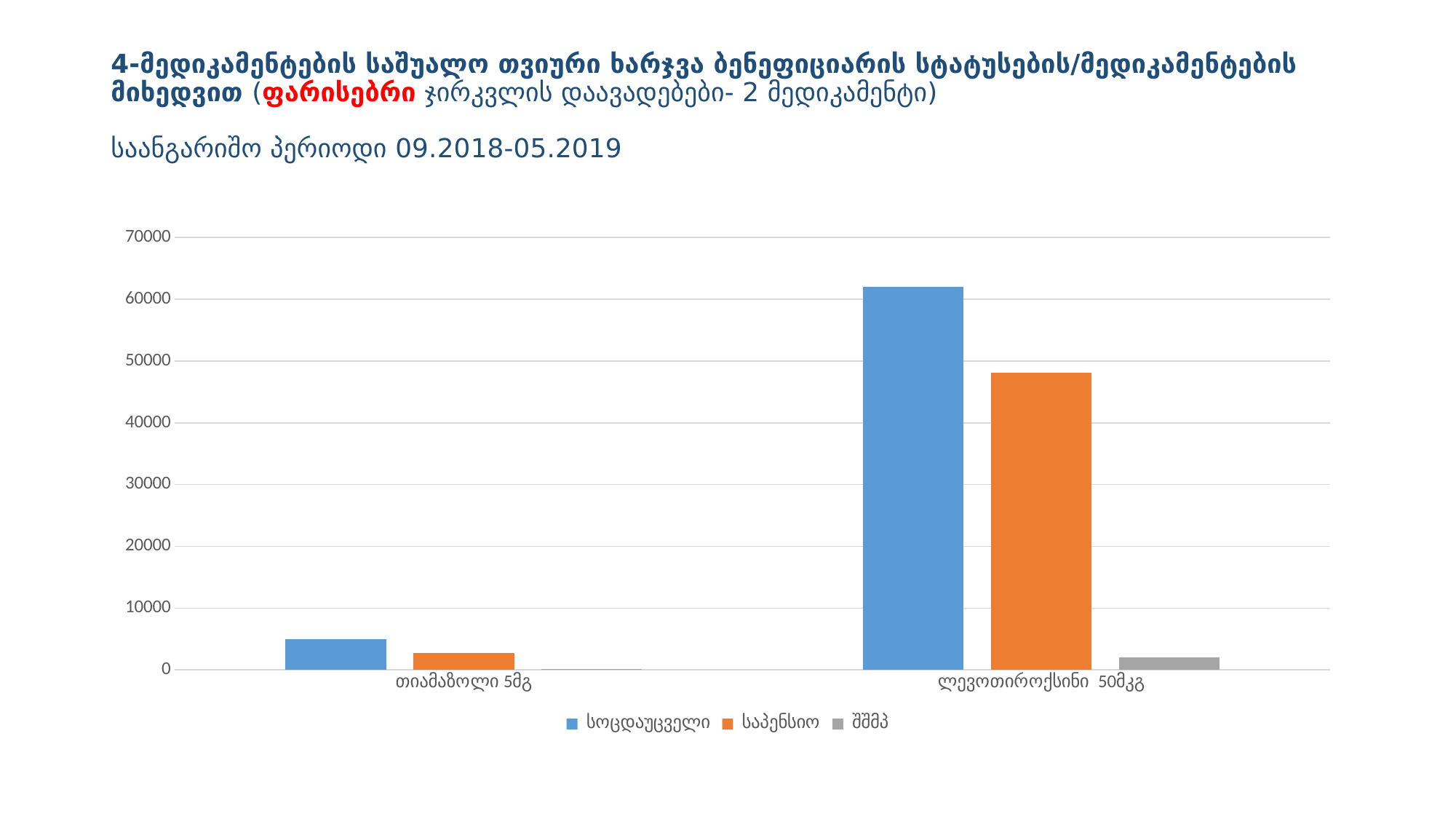
For ლევოთიროქსინი 50მკგ, which is larger: the სოცდაუცველი value or the საპენსიო value? სოცდაუცველი What calculation period is stated on the slide? 09.2018-05.2019 For თიამაზოლი 5მგ, which is larger: the სოცდაუცველი value or the საპენსიო value? სოცდაუცველი Is the საპენსიო value for ლევოთიროქსინი 50მკგ greater or less than 50000? less How many series does the chart legend list? 3 What kind of chart is shown on the slide? bar chart Which series has the lowest value for ლევოთიროქსინი 50მკგ? შშმპ Is the სოცდაუცველი value for თიამაზოლი 5მგ greater or less than 10000? less Which category has the highest value for the სოცდაუცველი series? ლევოთიროქსინი 50მკგ Which series is shown in orange in the chart? საპენსიო Is the სოცდაუცველი value for ლევოთიროქსინი 50მკგ greater or less than 60000? greater How many categories are shown on the x axis of the chart? 2